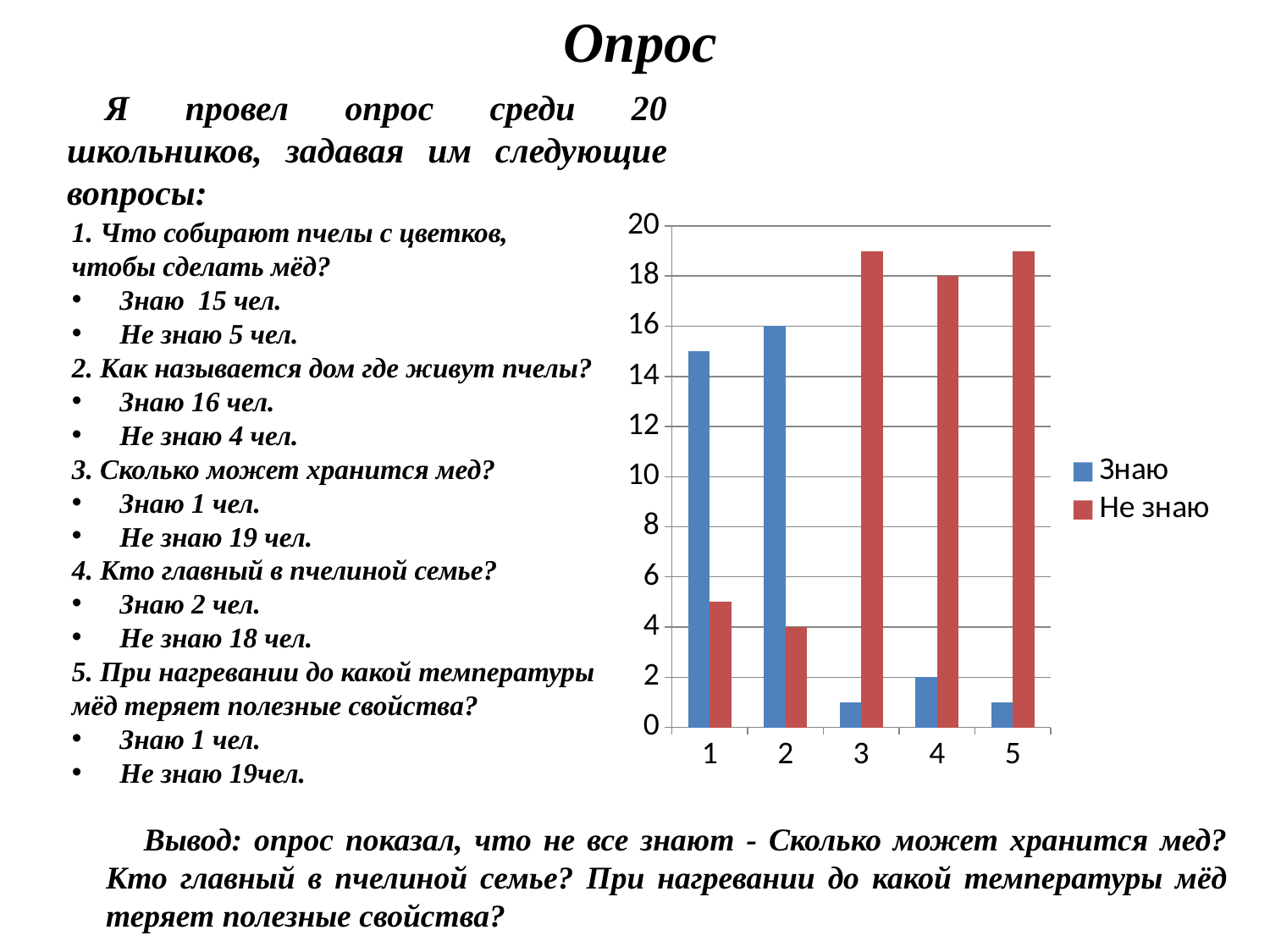
What is the difference between the "Знаю" and "Не знаю" values for category 2? 12 Which category has the lowest value for the "Не знаю" series? 2 What is the value of the "Не знаю" series for category 2? 4 What kind of chart is shown on the slide? bar chart Is the value of the "Не знаю" series for category 3 greater or less than 18? greater What is the value of the "Знаю" series for category 4? 2 For category 1, which series has the larger value, "Знаю" or "Не знаю"? Знаю What is the value of the "Не знаю" series for category 4? 18 How many series does the chart legend list? 2 Which category has the highest value for the "Знаю" series? 2 What is the value of the "Знаю" series for category 2? 16 How many categories are shown on the x axis of the chart? 5